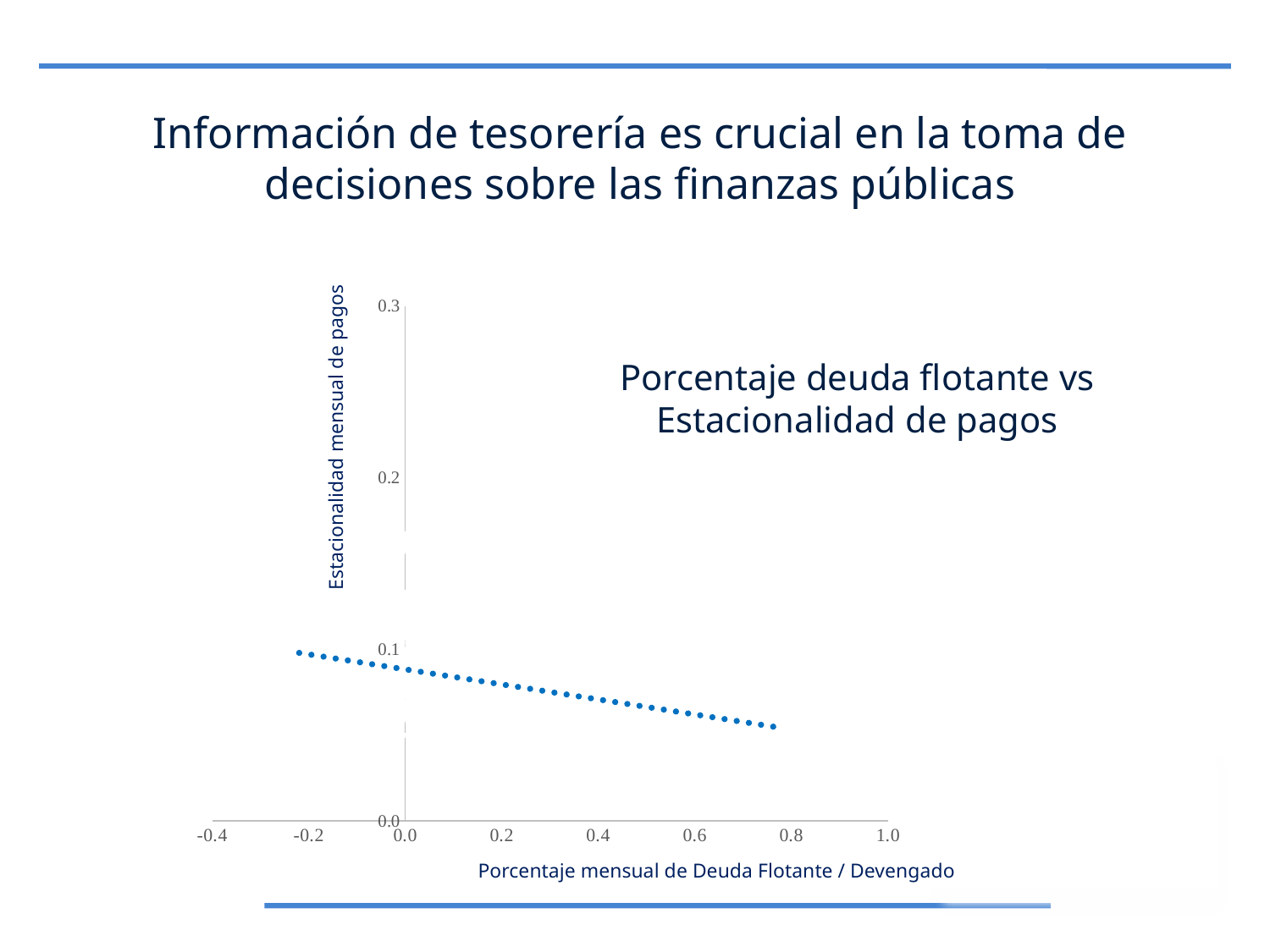
What is the label of the x axis? Porcentaje mensual de Deuda Flotante / Devengado What kind of chart is shown on the slide? scatter chart Which has the higher plotted value: the point at x = -0.2 or the point at x = 0.6? the point at x = -0.2 Is the plotted value at x = 0.4 greater or less than 0.2? less Is the plotted value at x = 0.6 greater or less than 0.1? less Is the plotted value at x = 0.6 greater or less than 0.0? greater What is the highest value shown on the y axis? 0.3 Which has the lower plotted value: the point at x = 0.0 or the point at x = 0.8? the point at x = 0.8 Do the plotted values rise or fall as the x-axis value increases? fall What is the title of the chart? Porcentaje deuda flotante vs Estacionalidad de pagos